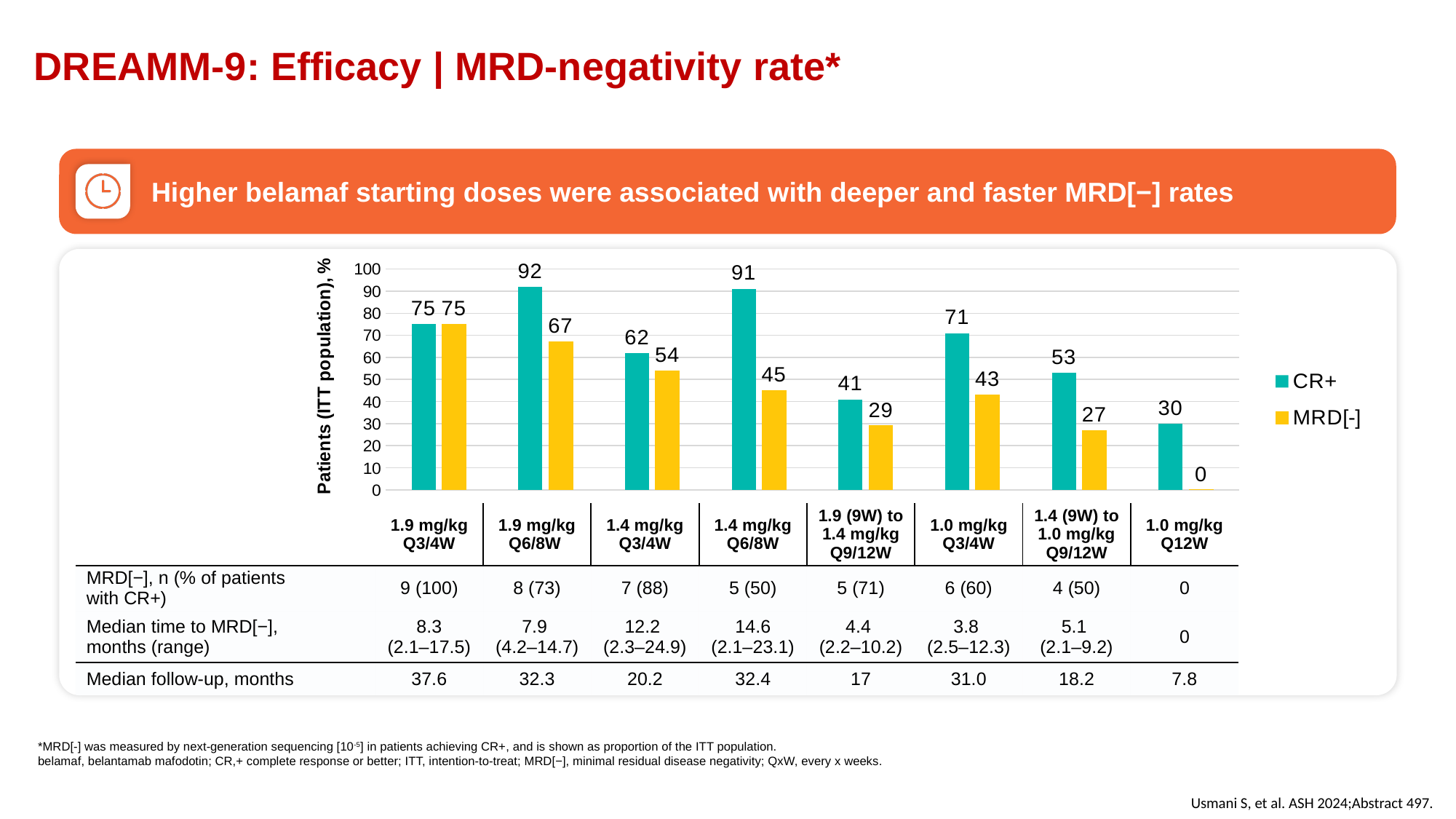
How many dose groups are shown on the x axis of the chart? 8 What is the MRD[-] value for the 1.4 mg/kg Q3/4W dose group? 54 What is the difference between the CR+ and MRD[-] values for the 1.4 mg/kg Q6/8W dose group? 46 How many series does the chart legend list? 2 What is the CR+ value for the 1.9 mg/kg Q6/8W dose group? 92 Which is larger, the MRD[-] value for 1.9 mg/kg Q6/8W or the MRD[-] value for 1.0 mg/kg Q3/4W? 1.9 mg/kg Q6/8W What is the MRD[-] value for the 1.0 mg/kg Q12W dose group? 0 Which dose group has the highest CR+ value? 1.9 mg/kg Q6/8W Which colour represents the MRD[-] series in the chart? Yellow What is the label of the y axis of the chart? Patients (ITT population), % What kind of chart is shown on the slide? Bar chart Which dose group has the lowest MRD[-] value? 1.0 mg/kg Q12W